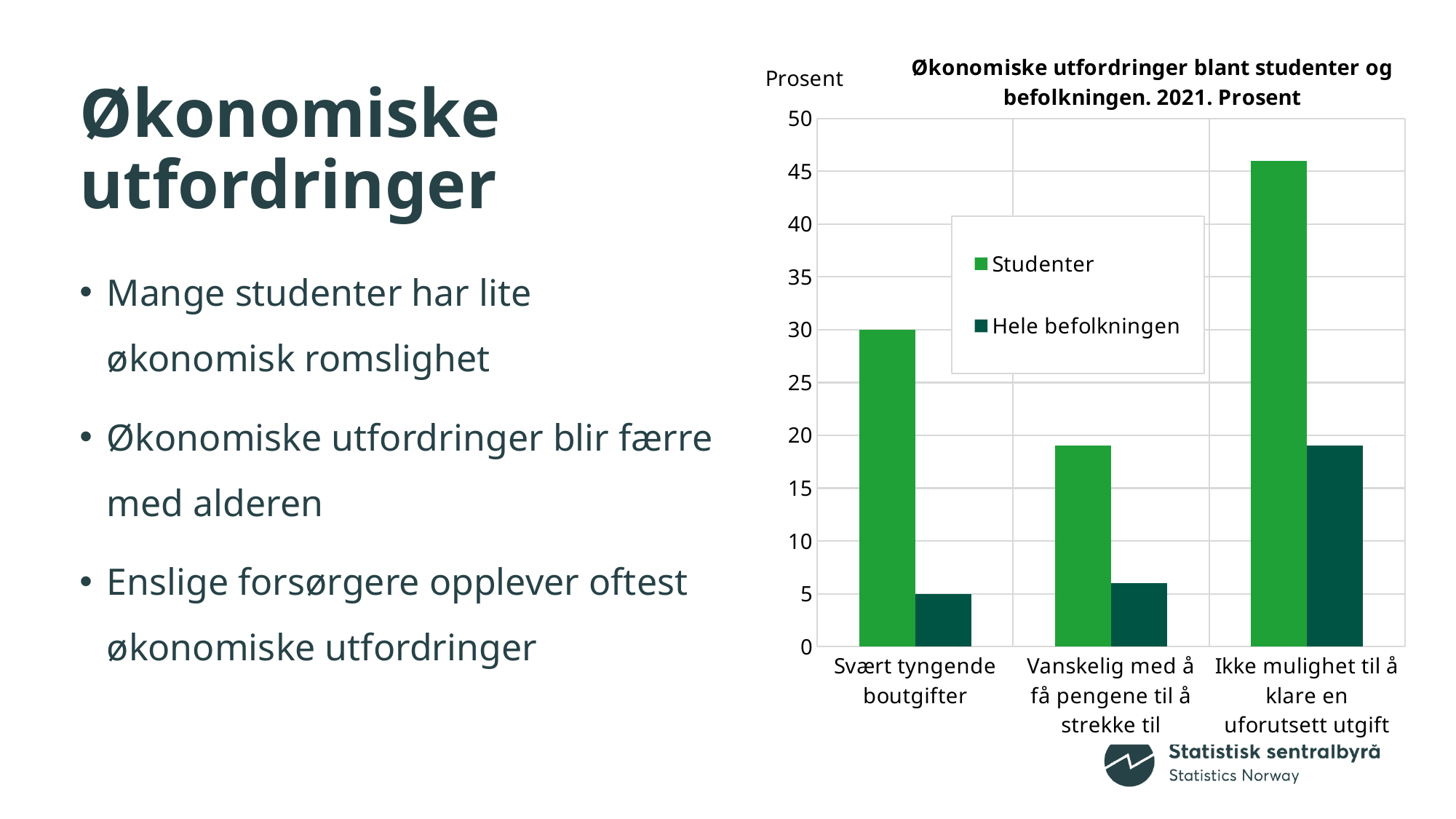
Is the value for Hele befolkningen in 'Vanskelig med å få pengene til å strekke til' greater or less than 10? less Which series is shown in dark green in the chart? Hele befolkningen What kind of chart is shown on the slide? bar chart How many series does the chart legend list? 2 Is the value for Studenter in 'Ikke mulighet til å klare en uforutsett utgift' greater or less than 40? greater Which category has the lowest value for Hele befolkningen? Svært tyngende boutgifter Which is larger in 'Svært tyngende boutgifter': the value for Studenter or for Hele befolkningen? Studenter What is the title of the chart? Økonomiske utfordringer blant studenter og befolkningen. 2021. Prosent Which category has the highest value for Studenter? Ikke mulighet til å klare en uforutsett utgift How many categories are shown on the x axis of the chart? 3